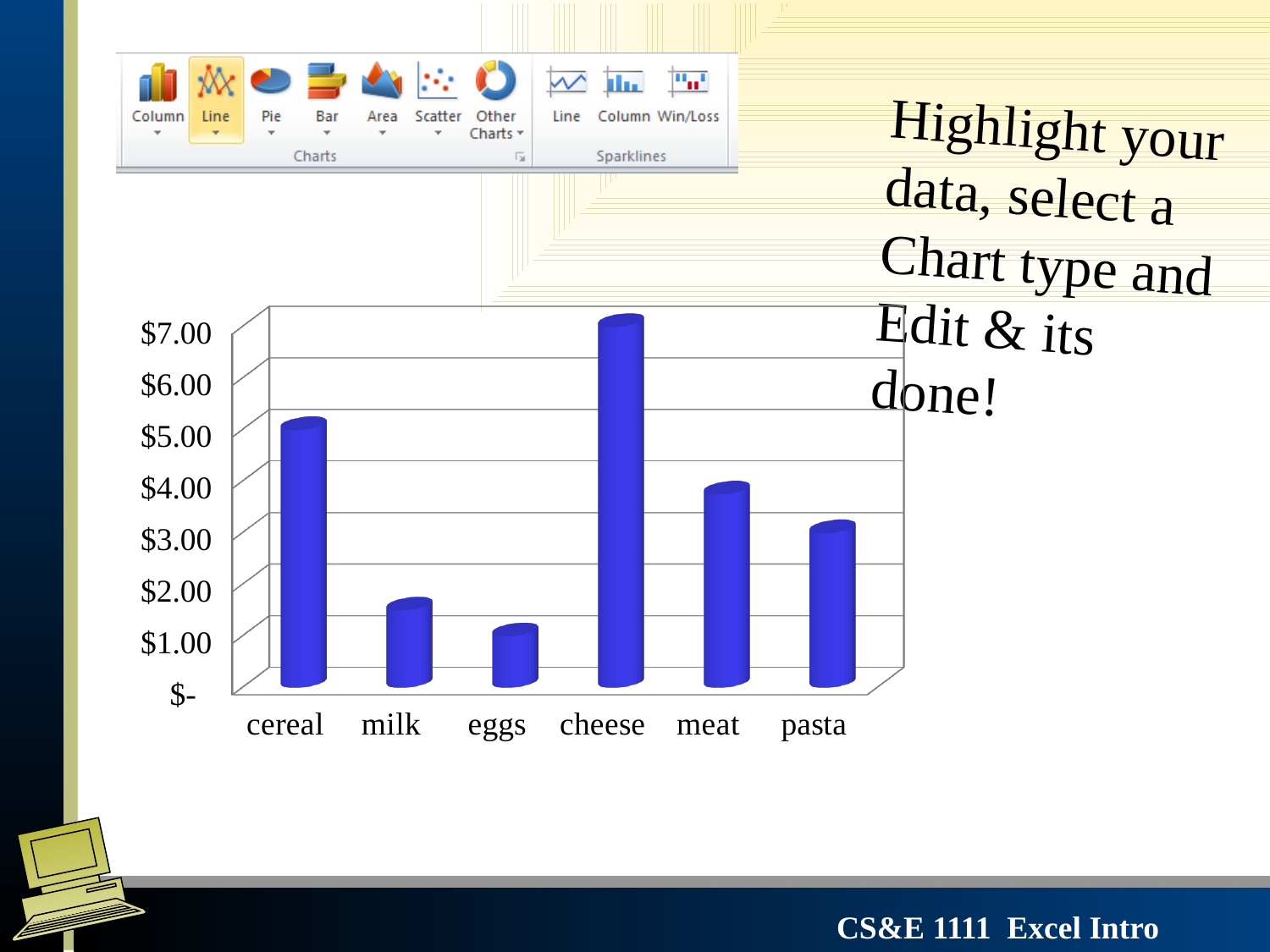
Which is larger, the value for cereal or the value for meat? cereal Is the value for cheese greater or less than $6.00? greater Which category has the highest value in the chart? cheese Which category has the lowest value in the chart? eggs Which is larger, the value for milk or the value for pasta? pasta Is the value for cereal greater or less than $4.00? greater How many categories are shown on the x axis of the chart? 6 Is the value for pasta greater or less than $4.00? less What kind of chart is shown on the slide? bar chart What colour are the bars in the chart? blue